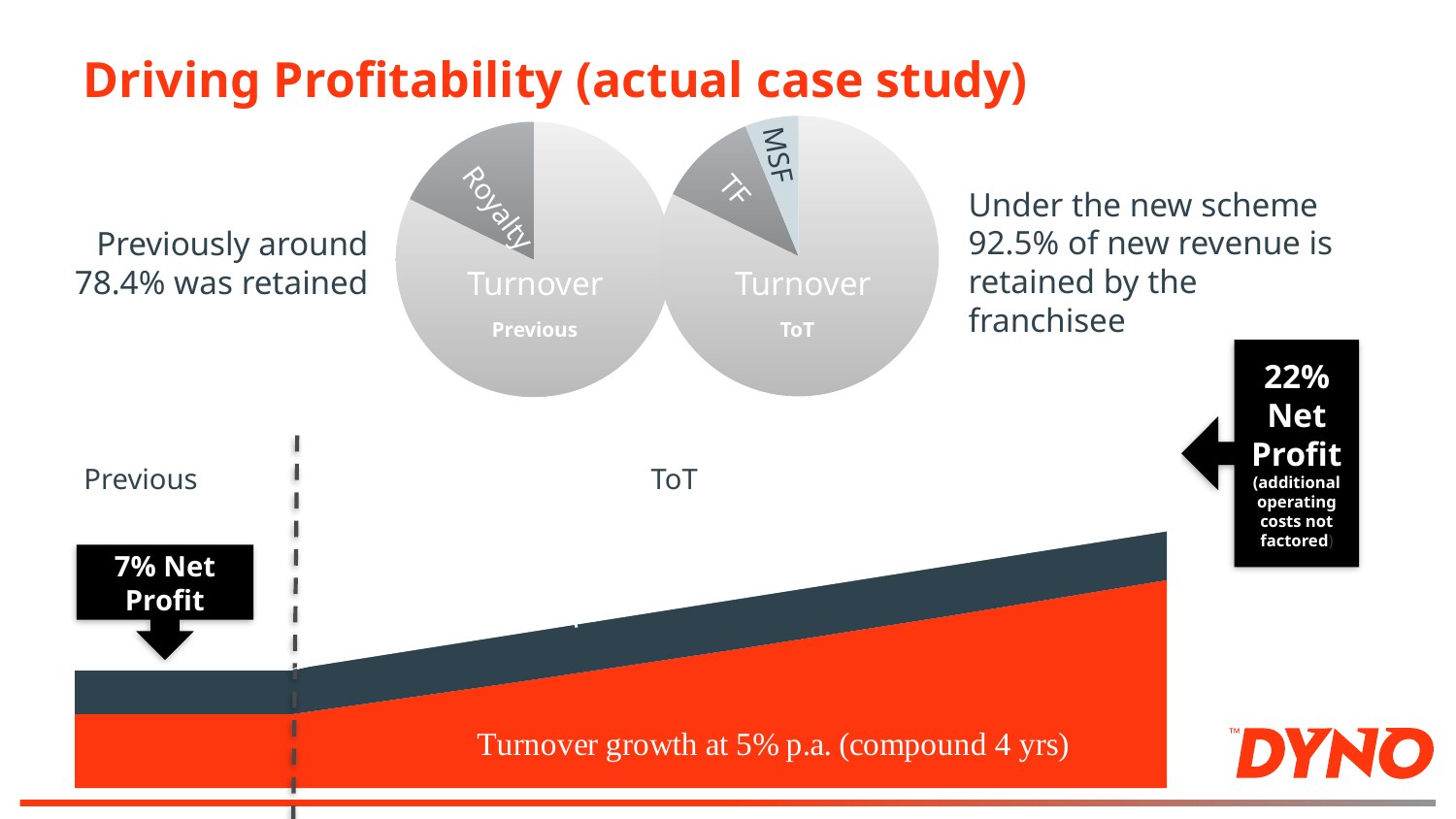
In the bottom chart, how much higher is the ToT net profit than the Previous net profit? 15 percentage points In the Previous pie chart, how many slices are there? 2 According to the ToT pie chart text, what share of new revenue is retained by the franchisee under the new scheme? 92.5% In the ToT pie chart, what are the two smaller slices labelled? TF and MSF In the ToT pie chart, which slice is larger, TF or MSF? TF In the bottom chart, does turnover rise or fall across the ToT period? Rise In the ToT pie chart, how many slices are there? 3 In the Previous pie chart, what is the smaller slice labelled? Royalty What kind of charts are the two charts at the top of the slide? Pie charts In the bottom chart, what is the net profit shown for Previous? 7% In the Previous pie chart, which slice is the largest? Turnover In the bottom chart, what is the net profit shown for ToT? 22%